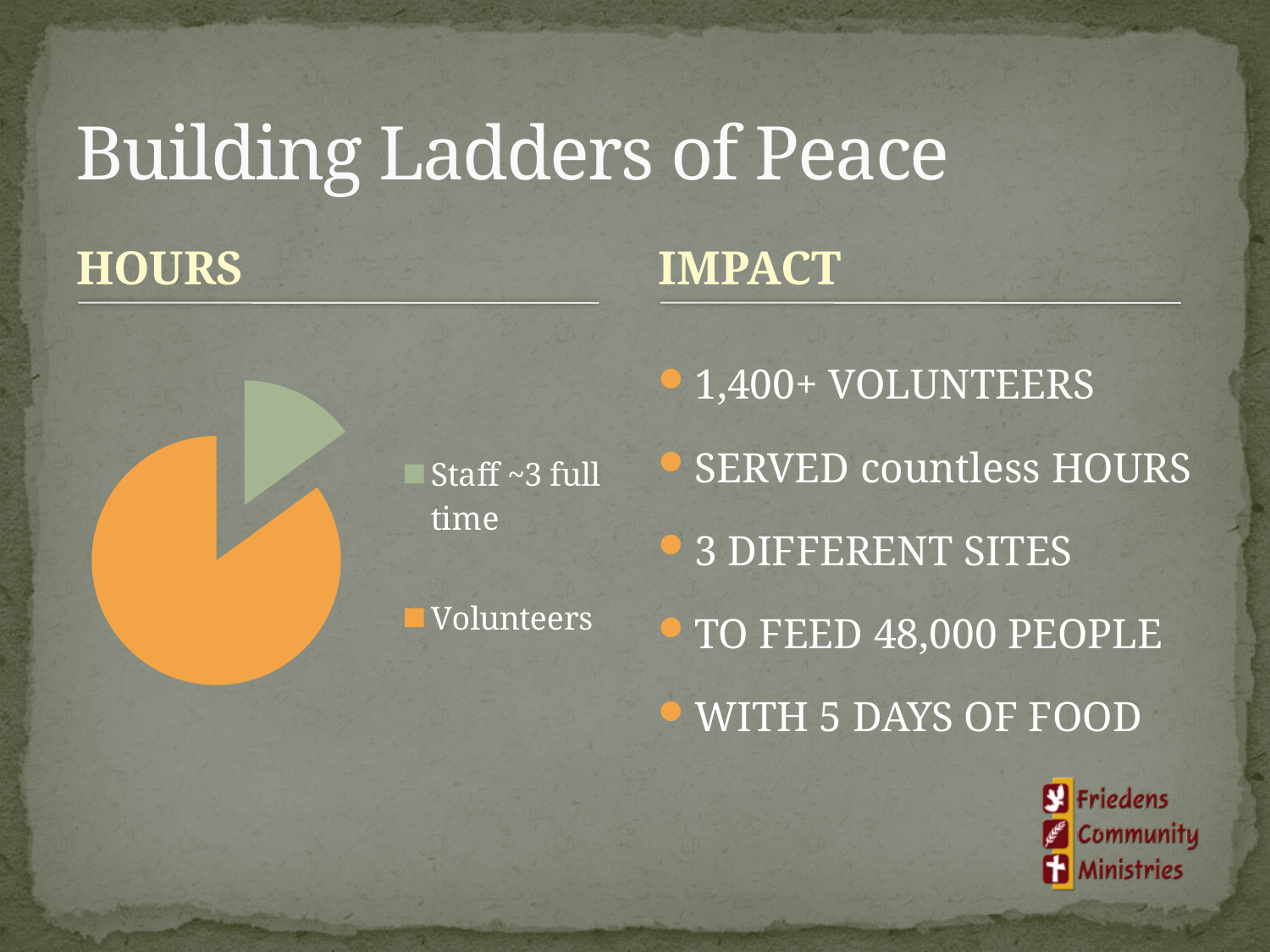
Which legend entry is shown in green in the pie chart? Staff ~3 full time How many entries does the pie chart's legend list? 2 Which category takes up the largest share of the pie chart? Volunteers How many slices does the pie chart have? 2 What kind of chart is shown under the HOURS heading? Pie chart Which slice is larger in the pie chart, Staff ~3 full time or Volunteers? Volunteers Which category takes up the smallest share of the pie chart? Staff ~3 full time What colour is the Volunteers slice in the pie chart? Orange